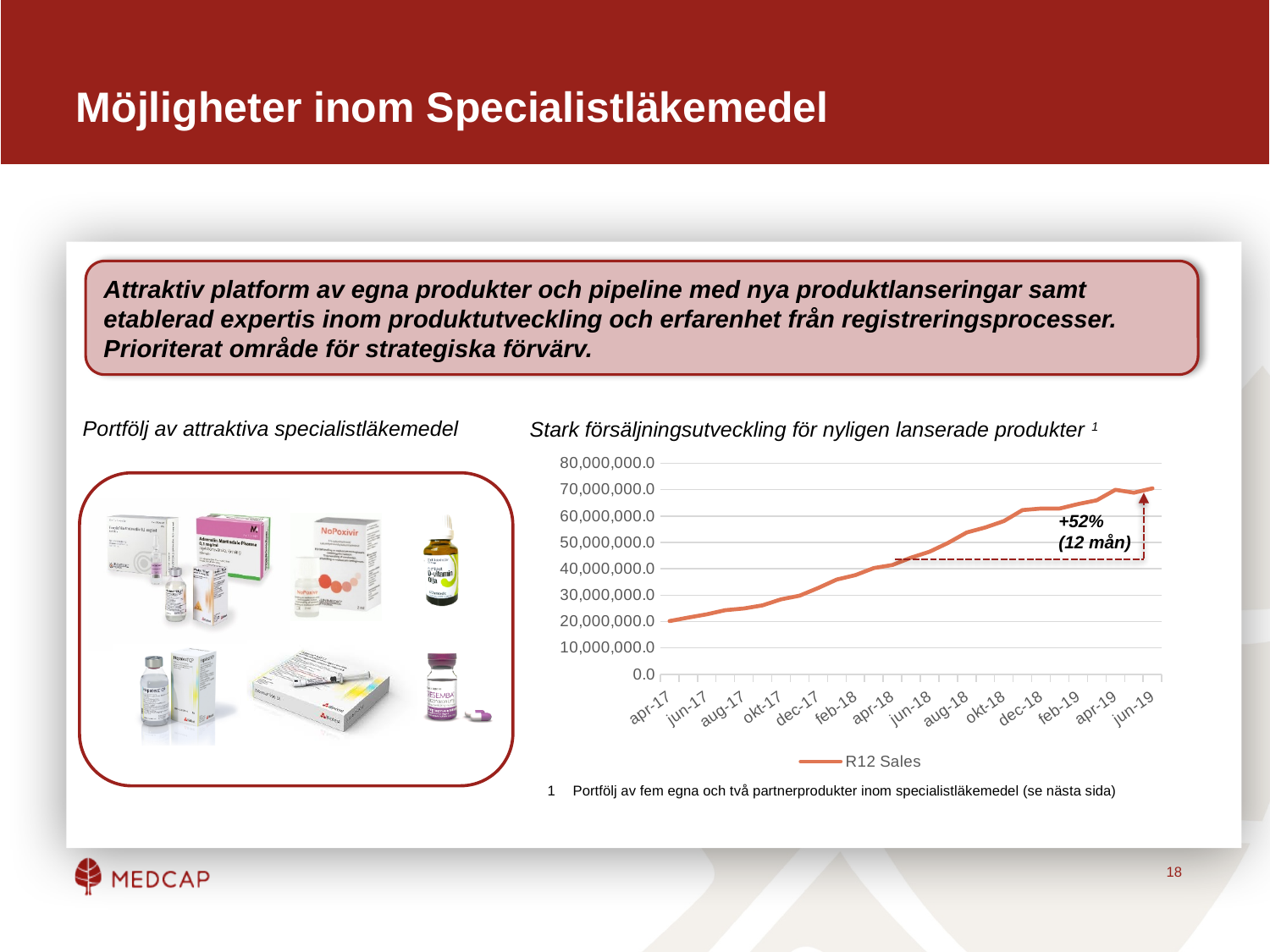
Which is larger, the R12 Sales value for aug-17 or for aug-18? aug-18 What kind of chart is shown under the heading 'Stark försäljningsutveckling för nyligen lanserade produkter'? line chart Is the R12 Sales value for jun-19 greater or less than 80,000,000.0? less Is the R12 Sales value for jun-18 greater or less than 40,000,000.0? greater Is the R12 Sales value for apr-17 greater or less than 30,000,000.0? less What is the name of the series shown in the legend of the sales chart? R12 Sales How many series does the legend of the sales chart list? 1 Which month on the x axis has the highest R12 Sales value? jun-19 Do the R12 Sales values rise or fall from apr-17 to jun-19? rise Which month on the x axis has the lowest R12 Sales value? apr-17 What percentage growth over 12 months is annotated on the sales chart? +52%